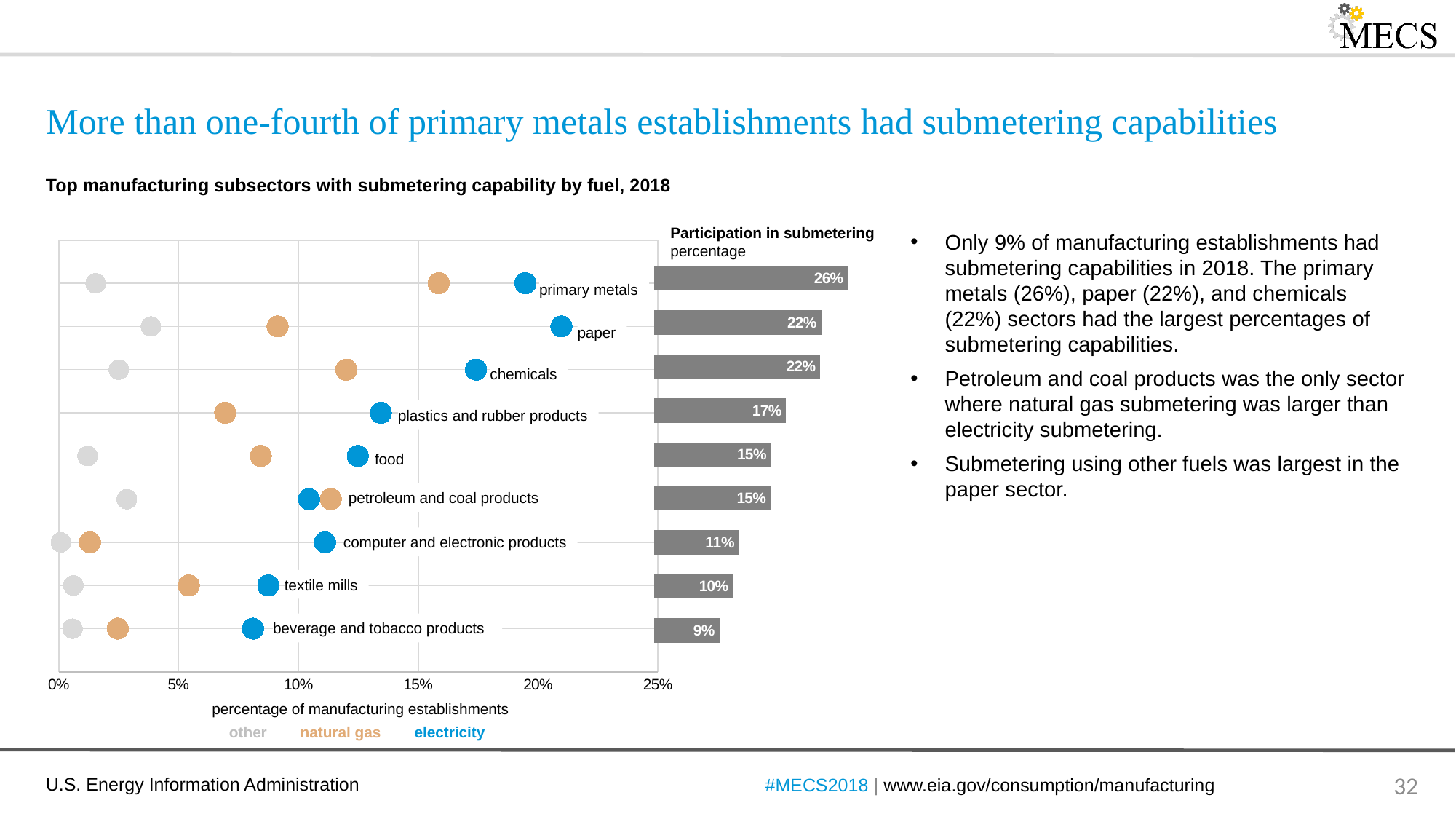
In the 'Participation in submetering' bar chart, which sector has the lowest participation percentage? beverage and tobacco products What kind of chart is shown on the right side under 'Participation in submetering'? bar chart In the 'Participation in submetering' bar chart, what is the value for plastics and rubber products? 17% In the 'Participation in submetering' bar chart, what is the difference between the values for primary metals and beverage and tobacco products? 17 percentage points How many sectors are shown in the dot chart on the left? 9 How many series does the legend of the dot chart on the left list? 3 In the 'Participation in submetering' bar chart, what is the value for primary metals? 26% In the 'Participation in submetering' bar chart, which is larger: the value for food or the value for computer and electronic products? food In the dot chart on the left, is the electricity value for beverage and tobacco products greater or less than 10%? less In the dot chart on the left, is the electricity value for primary metals greater or less than 15%? greater In the 'Participation in submetering' bar chart, which sector has the highest participation percentage? primary metals In the dot chart on the left, which is larger for paper: the electricity value or the natural gas value? electricity